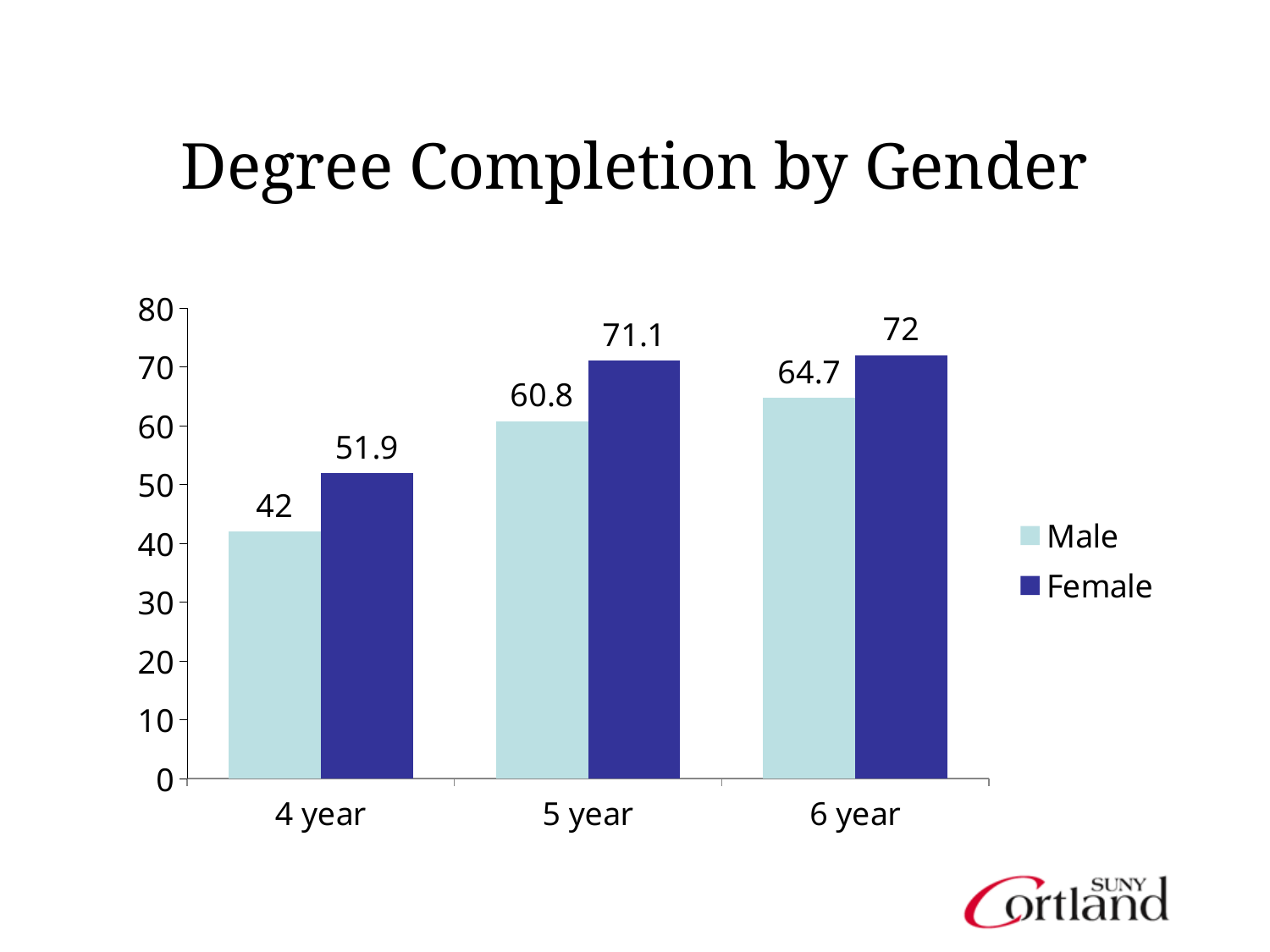
What is the Male value for 6 year? 64.7 What kind of chart is shown on the slide? bar chart What is the Female value for 5 year? 71.1 What is the Male value for 4 year? 42 Which category has the highest Female value? 6 year How many series does the legend list? 2 Which category has the lowest Male value? 4 year Which is larger for 5 year, the Male value or the Female value? Female What is the difference between the Female and Male values for 4 year? 9.9 How many categories are shown on the x axis? 3 Is the Male value for 5 year greater or less than 50? greater Do the Male values rise or fall from 4 year to 6 year? rise